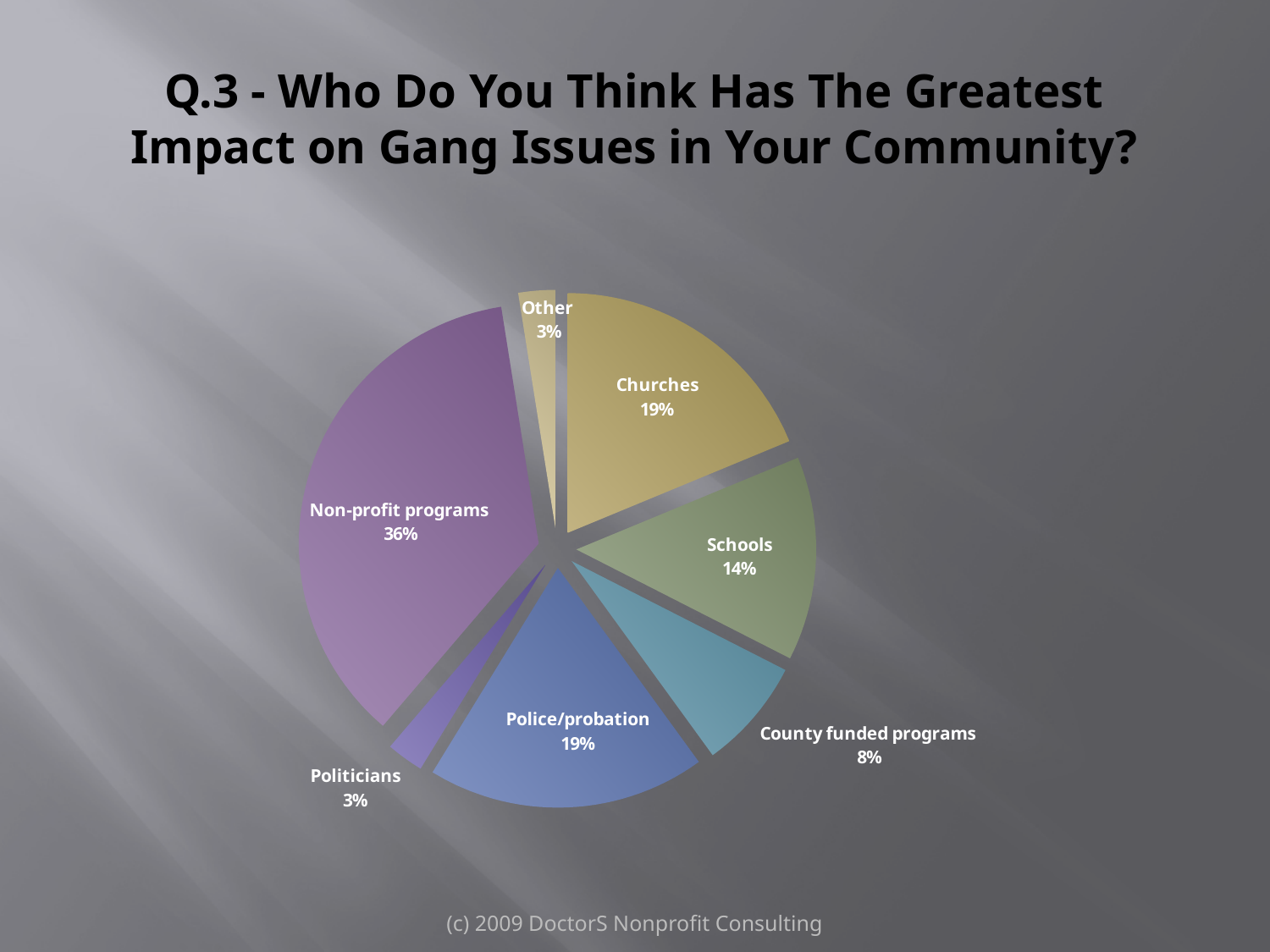
What is the combined percentage of Churches and Schools? 33% What share of the pie is Non-profit programs? 36% What percentage is shown for Politicians? 3% What is the difference in percentage points between Non-profit programs and Police/probation? 17 Which is larger, the slice for Schools or the slice for County funded programs? Schools What kind of chart is shown on the slide? pie chart Which category has the largest slice of the pie? Non-profit programs What percentage is shown for Schools? 14% How many slices does the pie chart have? 7 What percentage is shown for Churches? 19% What is the title of the chart? Q.3 - Who Do You Think Has The Greatest Impact on Gang Issues in Your Community? What percentage is shown for County funded programs? 8%